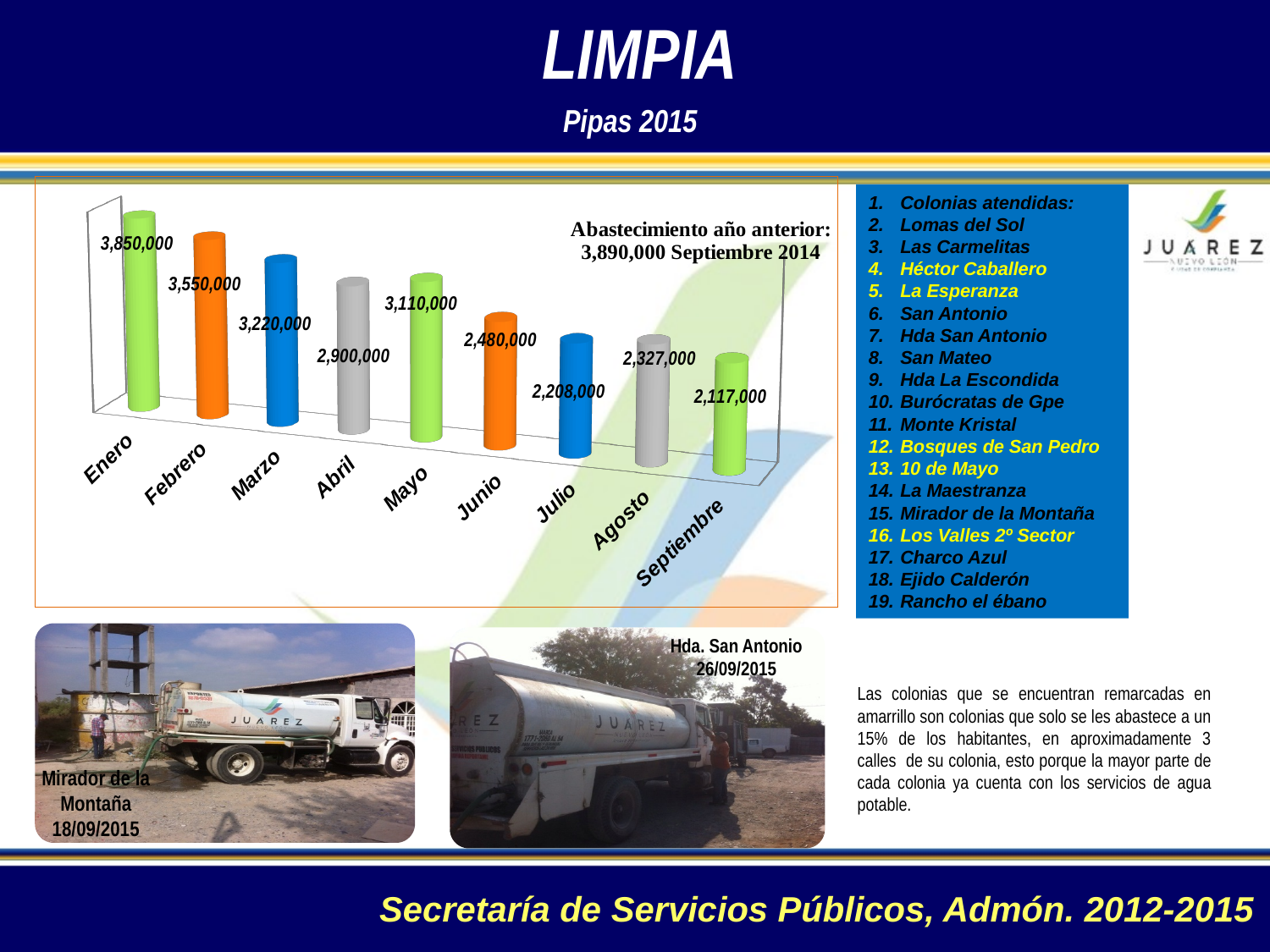
What is the difference between the values for Enero and Febrero? 300,000 What is the difference between the values for Agosto and Julio? 119,000 What kind of chart is shown on the slide? Bar chart How many months are plotted in the chart? 9 Which is larger, the value for Abril or the value for Mayo? Mayo Which month has the lowest value? Septiembre What is the value for Mayo? 3,110,000 What is the value for Septiembre? 2,117,000 Which is larger, the value for Junio or the value for Agosto? Junio What is the value for Enero? 3,850,000 Do the values generally rise or fall from Enero to Septiembre? Fall Which month has the highest value? Enero